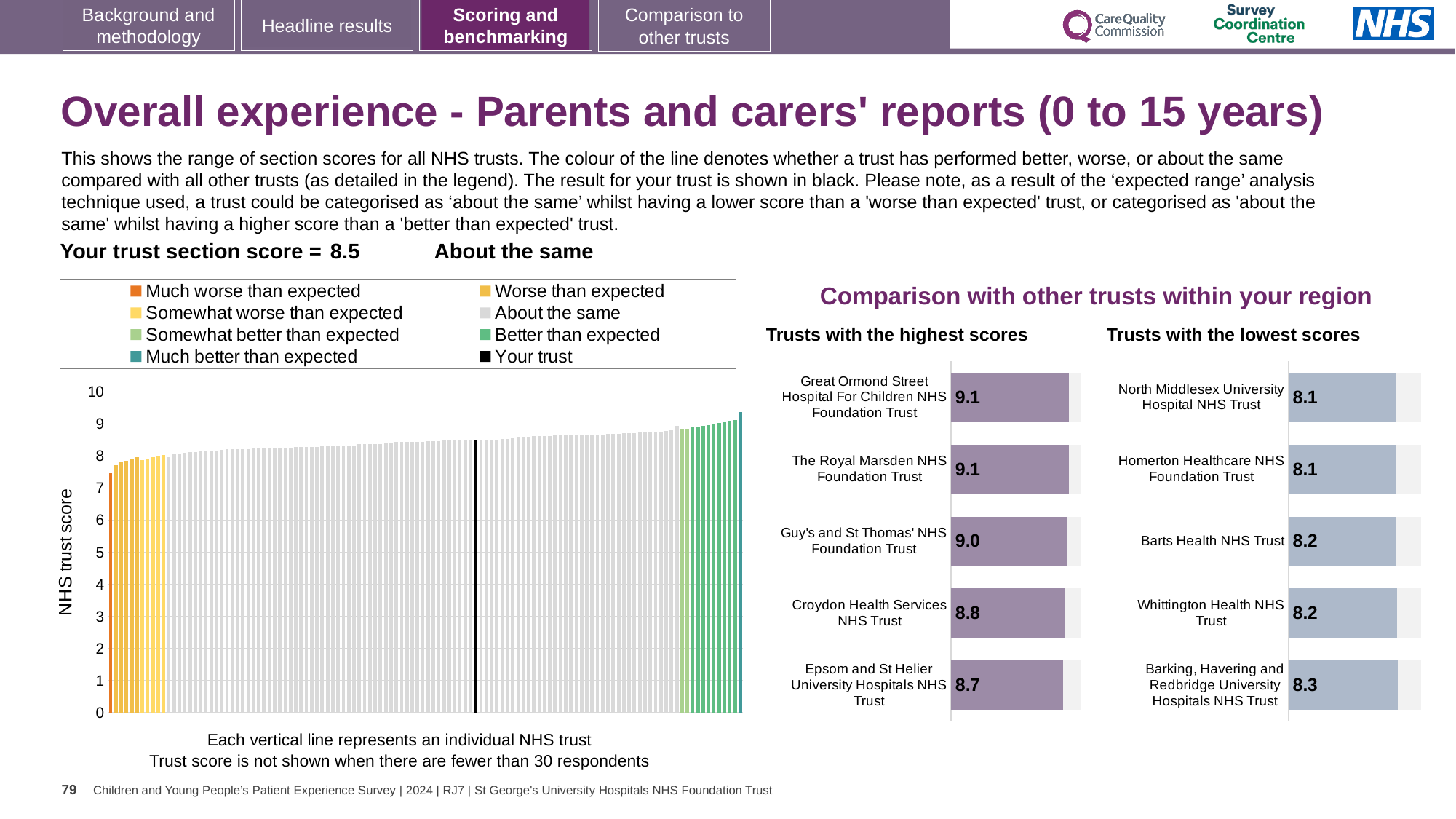
In the main chart on the left, is the value for the lowest (orange) bar greater or less than 8? less In the 'Trusts with the highest scores' chart, what is the difference between the scores of Great Ormond Street Hospital For Children NHS Foundation Trust and Epsom and St Helier University Hospitals NHS Trust? 0.4 In the 'Trusts with the highest scores' chart, what is the score for Great Ormond Street Hospital For Children NHS Foundation Trust? 9.1 In the 'Trusts with the lowest scores' chart, what is the score for Barking, Havering and Redbridge University Hospitals NHS Trust? 8.3 What kind of chart is the main chart on the left of the slide? Bar chart In the main chart on the left, is the value for the highest bar greater or less than 9? greater How many entries does the legend of the main chart on the left list? 8 Which is larger: the score for Croydon Health Services NHS Trust in the highest scores chart or the score for Barts Health NHS Trust in the lowest scores chart? Croydon Health Services NHS Trust In the 'Trusts with the highest scores' chart, which trust has the lowest score? Epsom and St Helier University Hospitals NHS Trust In the 'Trusts with the highest scores' chart, what is the score for Croydon Health Services NHS Trust? 8.8 How many trusts are shown in the 'Trusts with the lowest scores' chart? 5 In the 'Trusts with the lowest scores' chart, which trust has the highest score? Barking, Havering and Redbridge University Hospitals NHS Trust